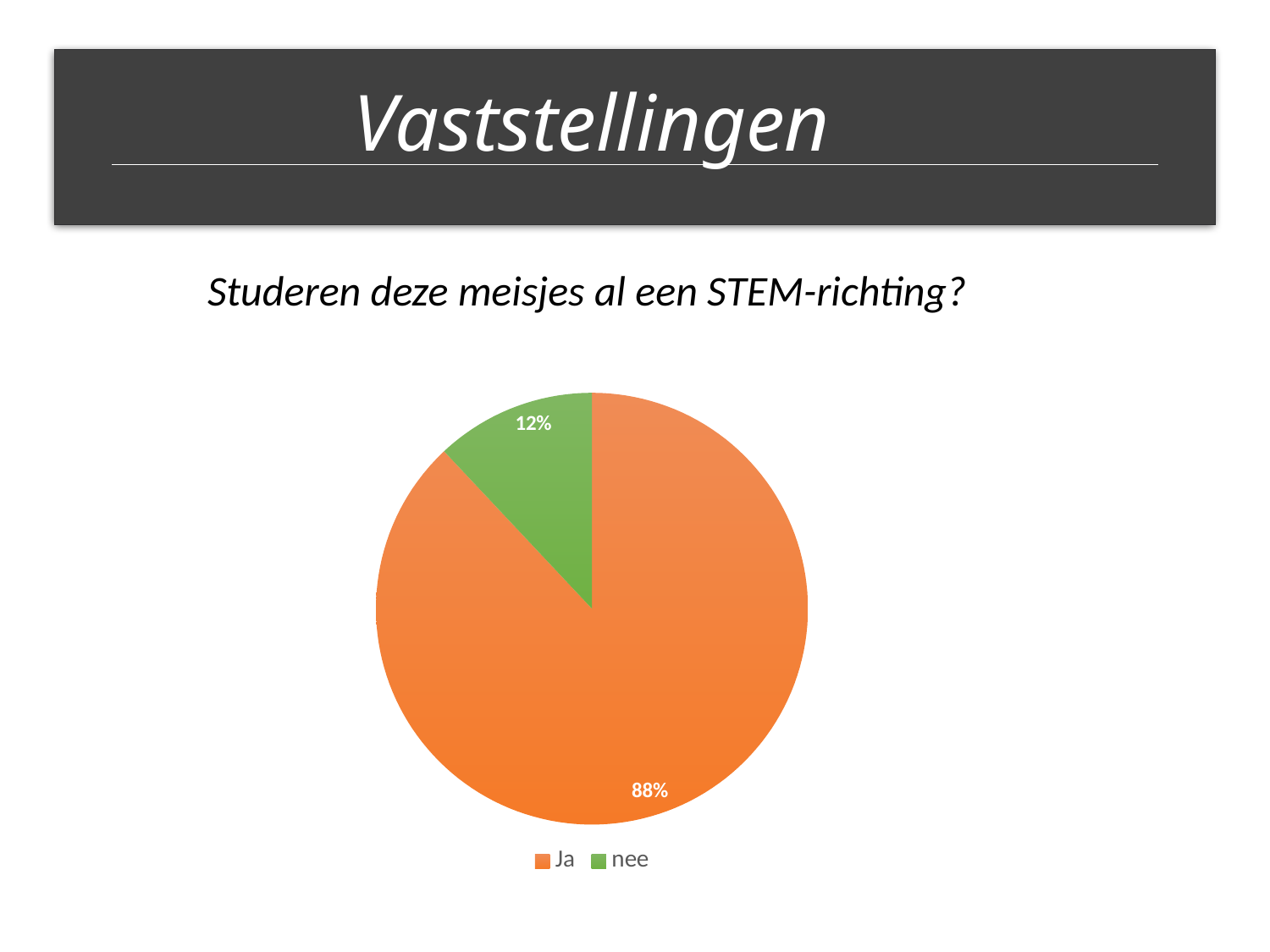
What kind of chart is shown on the slide? pie chart Which slice is the smallest? nee What share of the pie does "Ja" represent? 88% What colour is the "nee" slice? green What is the difference in percentage points between the "Ja" and "nee" slices? 76 What share of the pie does "nee" represent? 12% How many entries does the legend list? 2 How many slices does the pie chart have? 2 What question is written above the chart? Studeren deze meisjes al een STEM-richting? Which is larger, the "Ja" slice or the "nee" slice? Ja Which slice is the largest? Ja